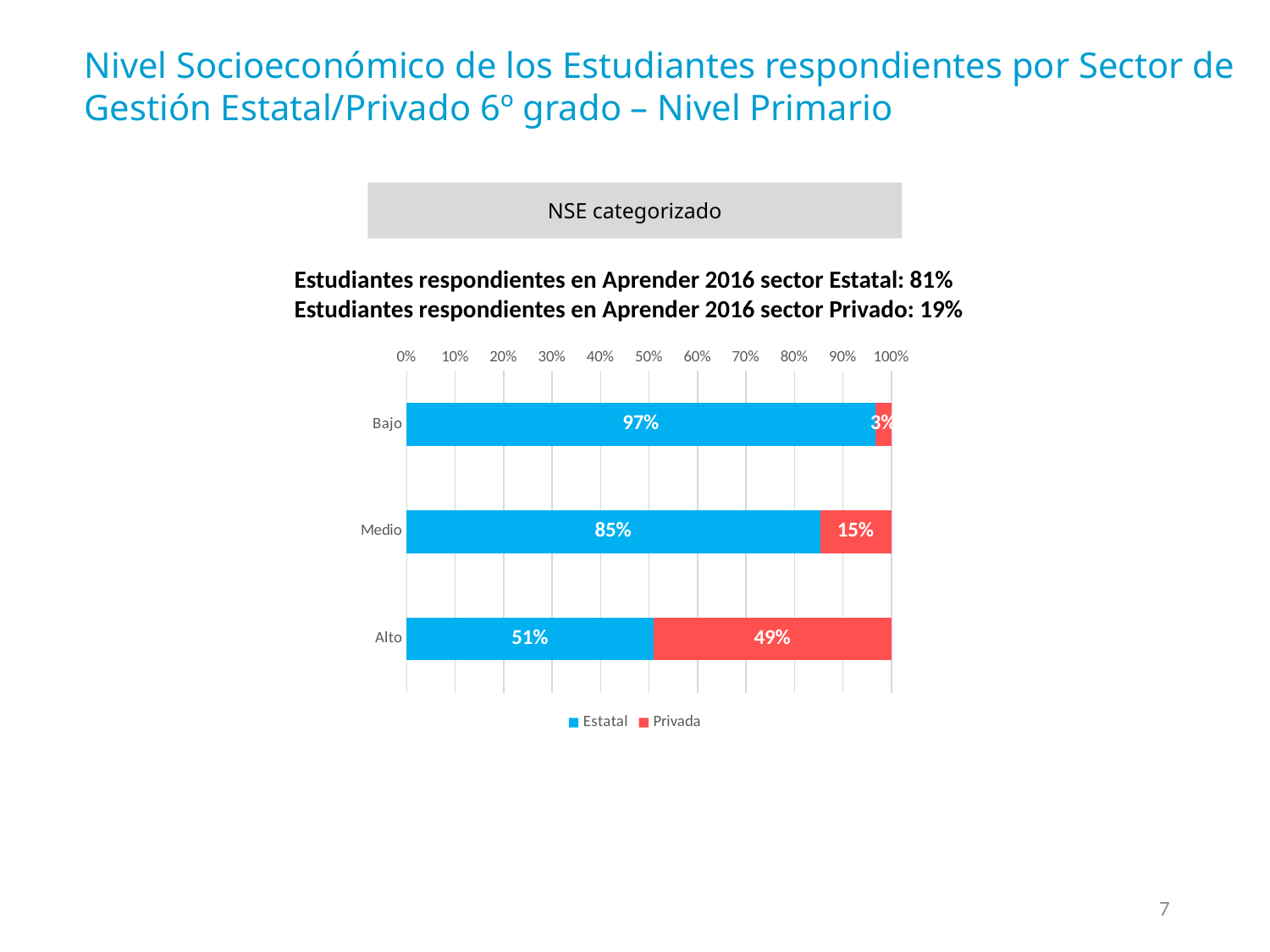
Which category has the lowest Privada value? Bajo How many categories are shown on the chart? 3 What is the Privada value for the Medio category? 15% What is the difference between the Estatal and Privada values for the Medio category? 70% Which is larger for the Alto category, the Estatal value or the Privada value? Estatal What is the total of the stacked bar for the Alto category? 100% What kind of chart is shown on the slide? Stacked bar chart What is the Estatal value for the Alto category? 51% Which category has the highest Estatal value? Bajo How many series does the legend list? 2 What is the Privada value for the Bajo category? 3% What is the Estatal value for the Bajo category? 97%